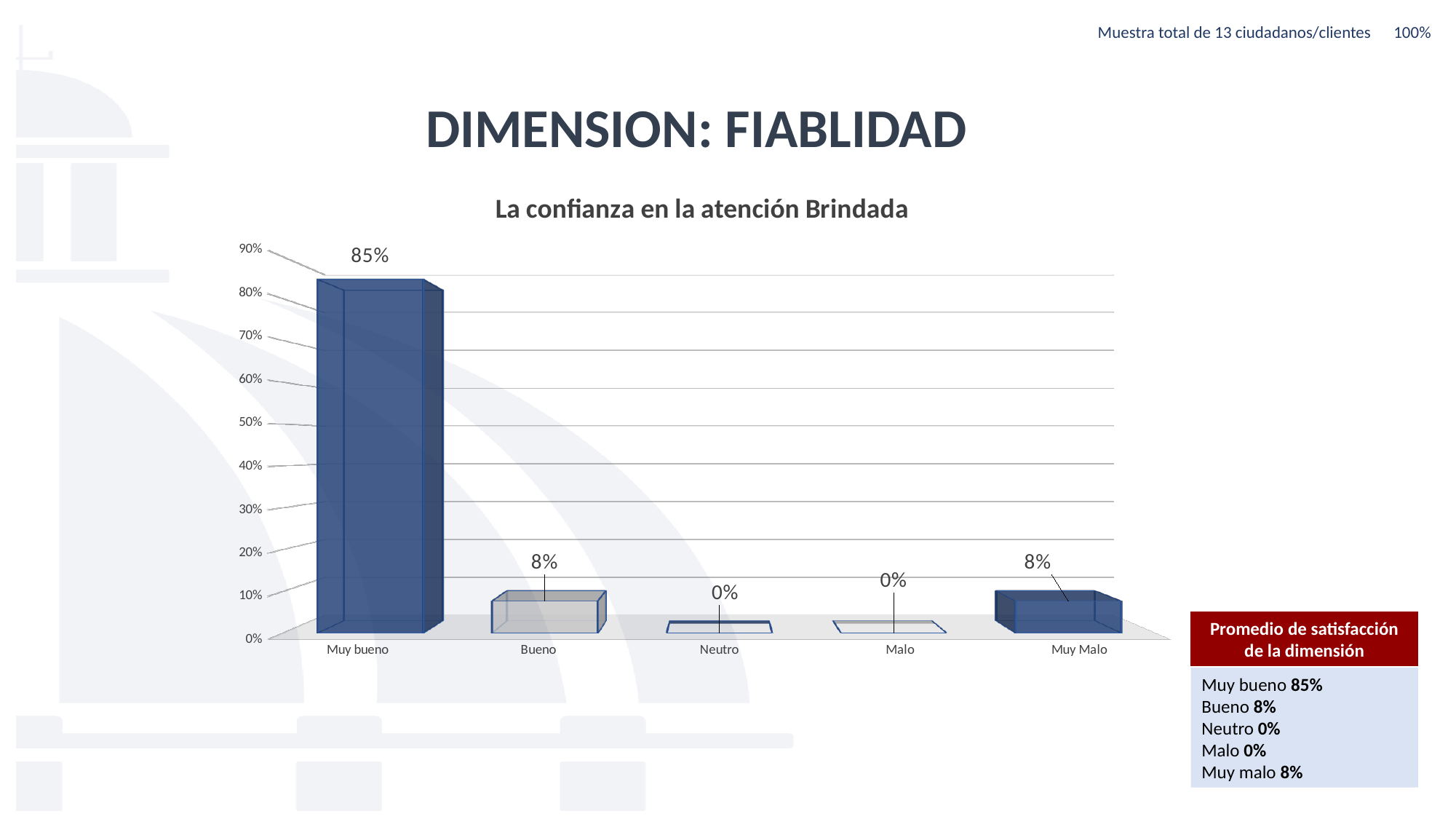
Is the value for Muy bueno greater or less than 80%? greater What is the title of the chart? La confianza en la atención Brindada What is the difference between the values for Muy bueno and Bueno? 77% What is the highest value shown on the y axis? 90% What is the value for Muy Malo? 8% How many categories are shown on the x axis? 5 What is the value for Neutro? 0% Which is larger, the value for Bueno or the value for Malo? Bueno Which category has the highest value? Muy bueno What is the value for Muy bueno? 85% What is the value for Bueno? 8% What kind of chart is shown? bar chart